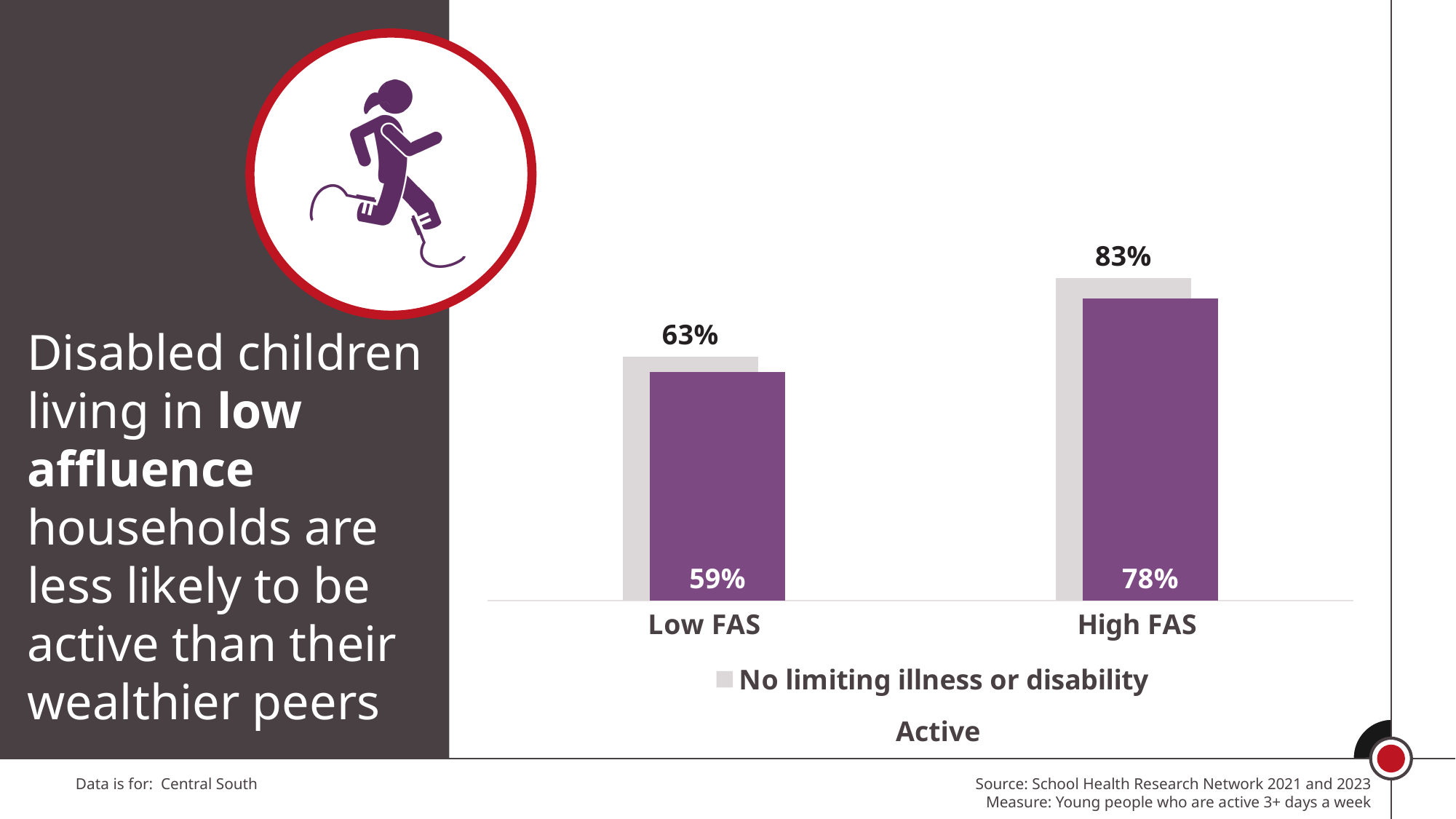
What is the value of the grey 'No limiting illness or disability' bar for Low FAS? 63% Which category has the higher purple bar value, Low FAS or High FAS? High FAS What is the value of the purple bar for Low FAS? 59% How many categories are shown on the x axis? 2 What is the difference between the grey and purple bars for High FAS? 5% Which bar has the lowest value on the chart? Purple bar for Low FAS (59%) What kind of chart is shown on the slide? bar chart What is the value of the purple bar for High FAS? 78% What is the value of the grey 'No limiting illness or disability' bar for High FAS? 83% What is the difference between the grey and purple bars for Low FAS? 4% What is the difference between the 'No limiting illness or disability' values for High FAS and Low FAS? 20% What series name does the legend list? No limiting illness or disability